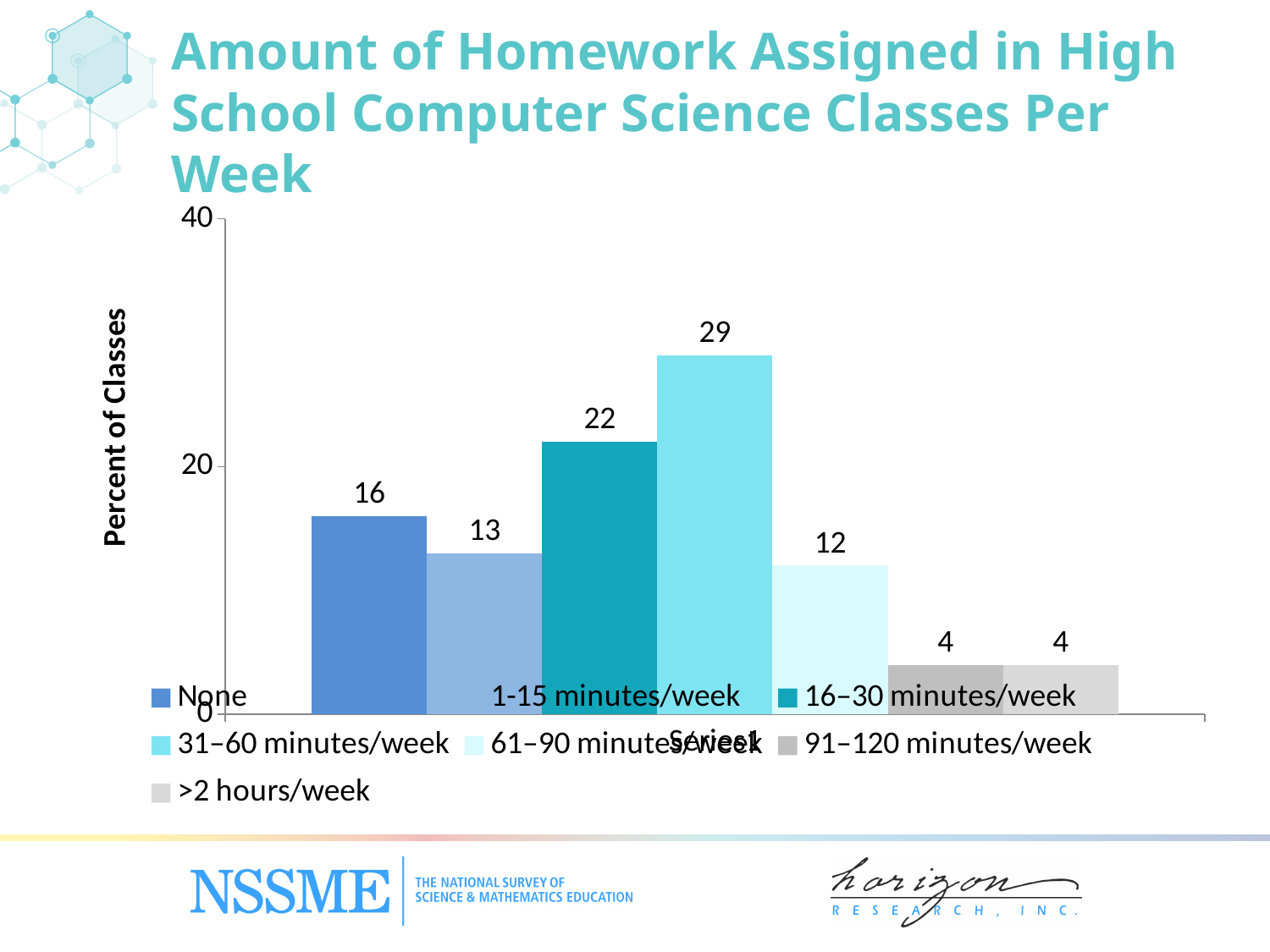
What is the value for 61–90 minutes/week? 12 How many bars are plotted on the chart? 7 What percent of classes are assigned 16–30 minutes/week of homework? 22 Which homework category has the highest percent of classes? 31–60 minutes/week What is the difference between the values for 31–60 minutes/week and 16–30 minutes/week? 7 How many series does the legend list? 7 What is the lowest value shown on the chart? 4 Which is larger, the value for None or the value for 1-15 minutes/week? None Is the value for 16–30 minutes/week greater or less than 20? greater What kind of chart is shown on the slide? Bar chart What percent of classes are assigned 31–60 minutes/week of homework? 29 What is the value for the None category? 16